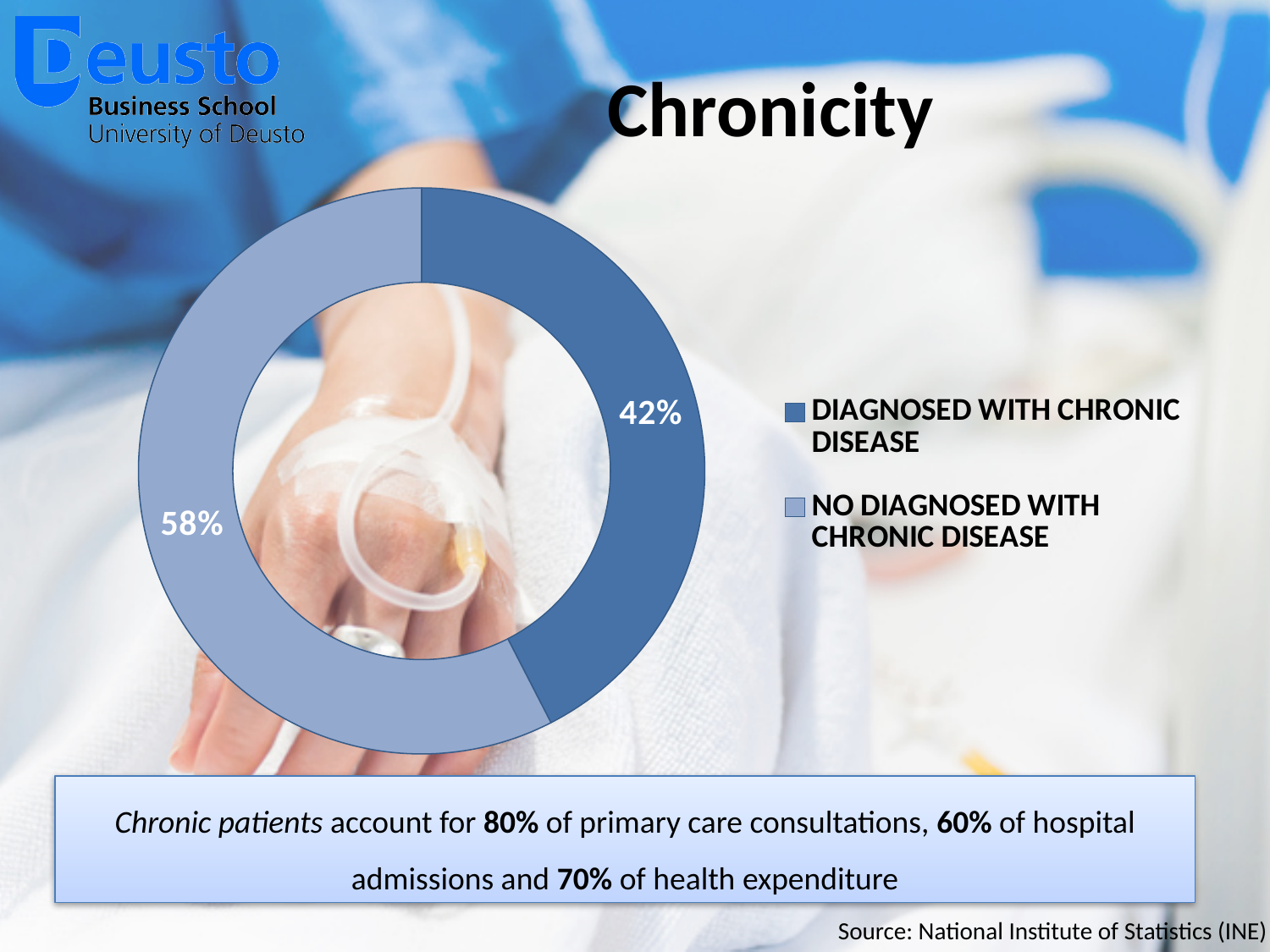
What percentage of the doughnut chart is labelled 'NO DIAGNOSED WITH CHRONIC DISEASE'? 58% Which category has the smaller share of the chart? DIAGNOSED WITH CHRONIC DISEASE Is the share for 'DIAGNOSED WITH CHRONIC DISEASE' greater or less than 50%? less What is the title of the slide containing the chart? Chronicity How many categories does the chart show? 2 Is the share for 'DIAGNOSED WITH CHRONIC DISEASE' larger or smaller than the share for 'NO DIAGNOSED WITH CHRONIC DISEASE'? smaller Which category has the larger share of the chart? NO DIAGNOSED WITH CHRONIC DISEASE Which legend entry is shown in the darker blue colour? DIAGNOSED WITH CHRONIC DISEASE What percentage of the doughnut chart is labelled 'DIAGNOSED WITH CHRONIC DISEASE'? 42% What is the difference in percentage points between the 'NO DIAGNOSED WITH CHRONIC DISEASE' and 'DIAGNOSED WITH CHRONIC DISEASE' slices? 16 percentage points What kind of chart is shown on the slide? doughnut chart How many entries does the legend list? 2